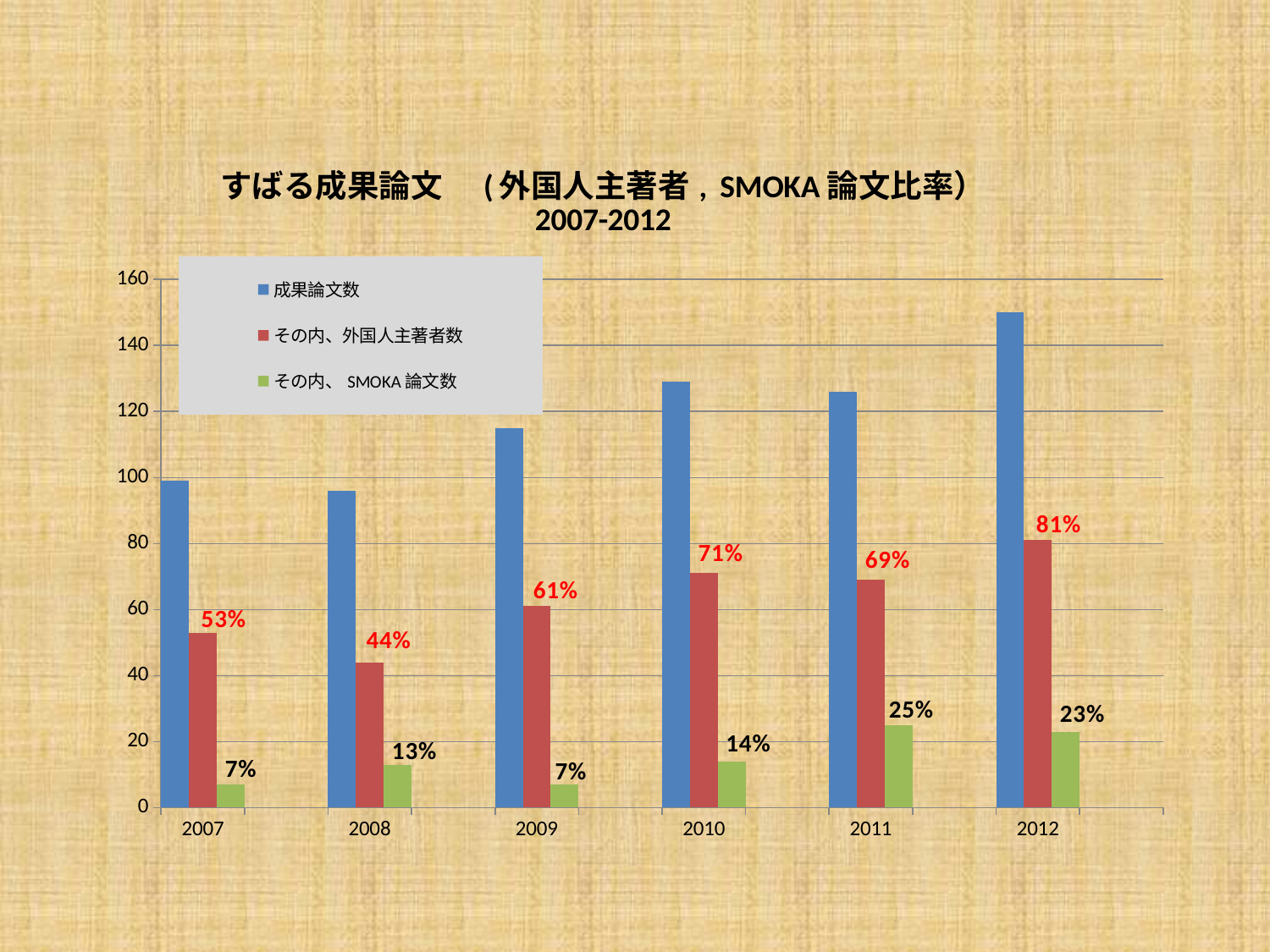
Which year has the highest 成果論文数 bar? 2012 What label is printed on the その内、 SMOKA 論文数 bar for 2011? 25% What label is printed on the その内、外国人主著者数 bar for 2008? 44% Which year has the lowest labelled value for その内、外国人主著者数? 2008 How many years are shown on the x axis? 6 What label is printed on the その内、外国人主著者数 bar for 2012? 81% Which year has the highest labelled value for その内、 SMOKA 論文数? 2011 What type of chart is shown on the slide? bar chart Which colour represents その内、 SMOKA 論文数 in the legend? green Is the 成果論文数 value for 2008 greater or less than 100? less How many series does the legend list? 3 Is the 成果論文数 value for 2012 greater or less than 140? greater